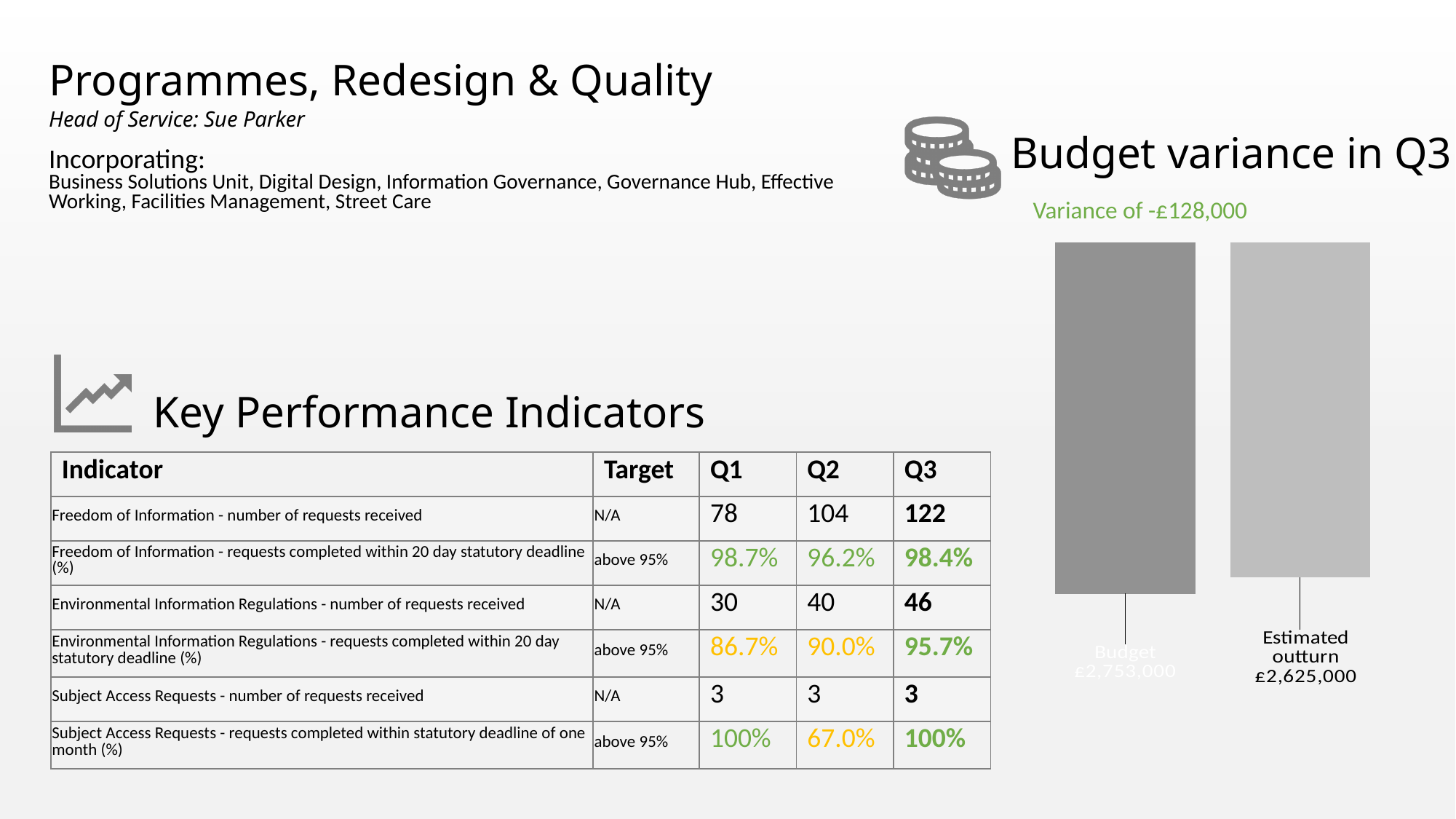
What kind of chart is used to show the budget variance in Q3? Bar chart Which category has the lowest value in the Budget variance in Q3 chart? Estimated outturn What is the value of the Budget bar in the Budget variance in Q3 chart? £2,753,000 What is the difference between the Budget and the Estimated outturn in the Budget variance in Q3 chart? £128,000 What variance is stated above the Budget variance in Q3 chart? Variance of -£128,000 What is the value of the Estimated outturn bar in the Budget variance in Q3 chart? £2,625,000 Which category has the highest value in the Budget variance in Q3 chart? Budget How many bars are shown in the Budget variance in Q3 chart? 2 Which bar is taller in the Budget variance in Q3 chart, Budget or Estimated outturn? Budget What is the title of the chart on the right side of the slide? Budget variance in Q3